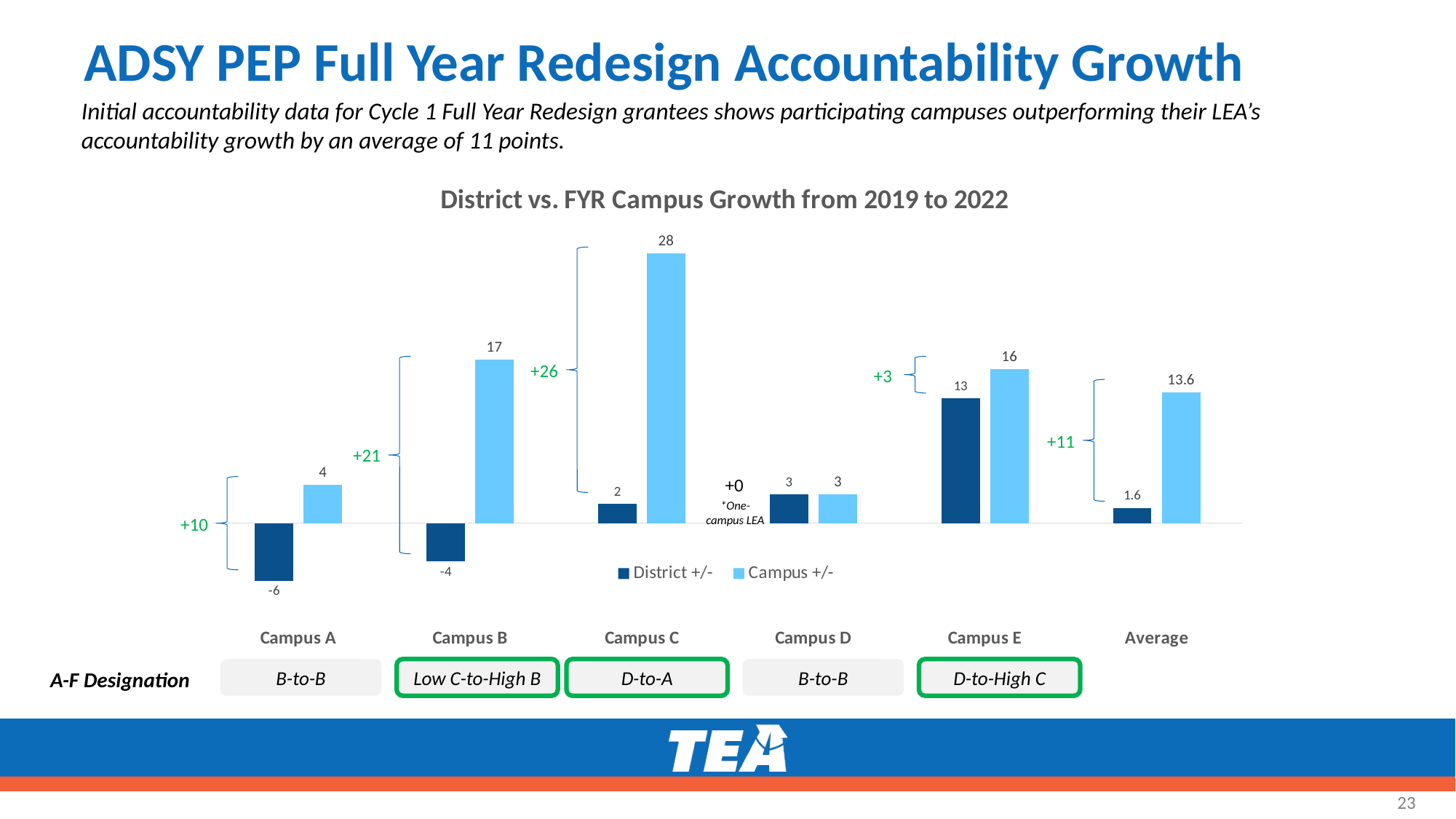
What is the District +/- value for Campus A? -6 Which is larger for Campus E, the District +/- value or the Campus +/- value? Campus +/- How many series does the legend list? 2 Which category has the lowest District +/- value? Campus A What is the Campus +/- value for the Average category? 13.6 What is the District +/- value for Campus E? 13 What kind of chart is shown on the slide? Bar chart What is the title of the chart? District vs. FYR Campus Growth from 2019 to 2022 What is the Campus +/- value for Campus C? 28 Which category has the highest Campus +/- value? Campus C What is the difference between the Campus +/- and District +/- values for Campus B? 21 How many categories are shown on the x axis of the chart? 6